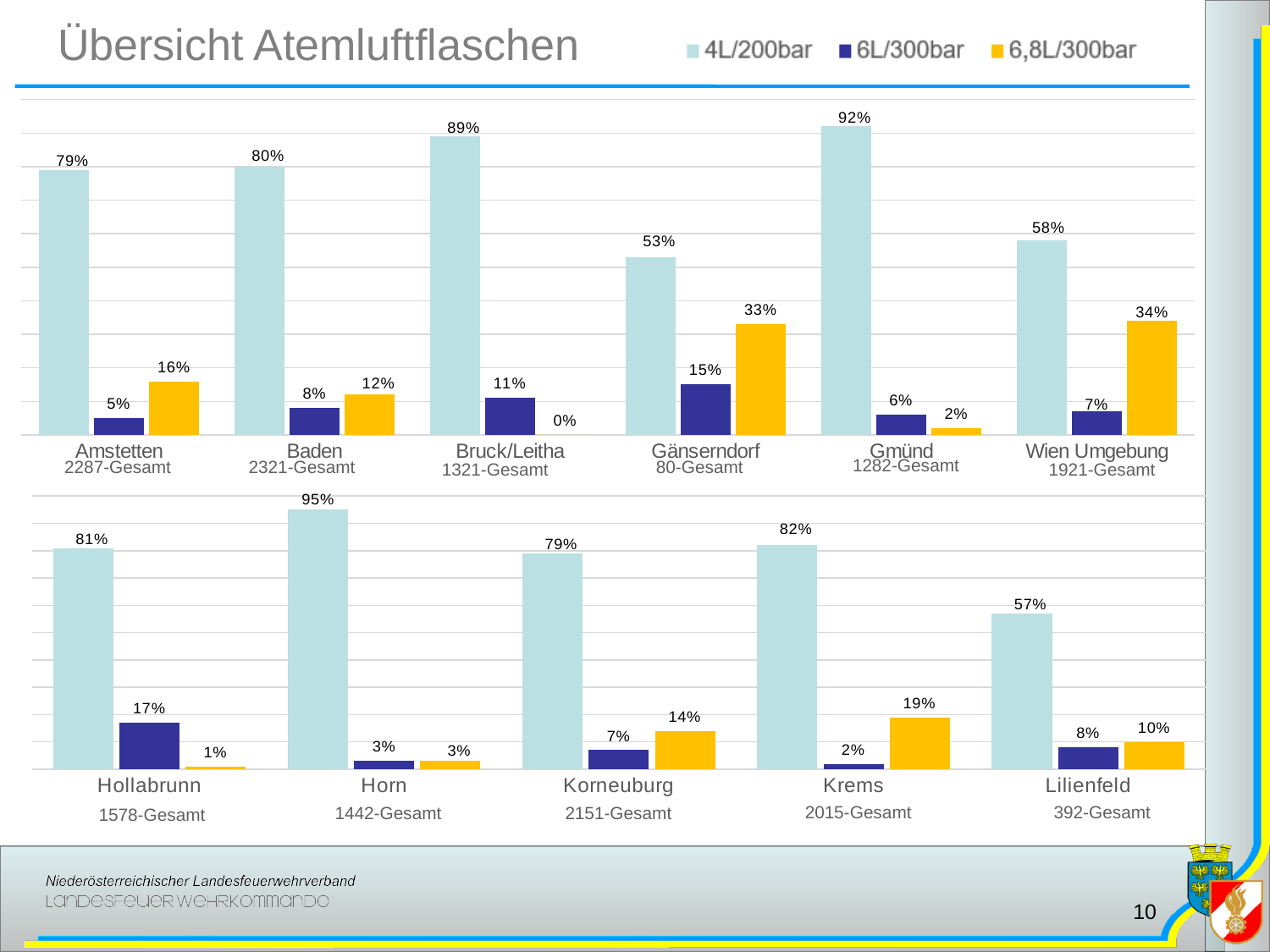
How many series does the legend list? 3 In the top chart, what is the 4L/200bar value for Gmünd? 92% What kind of chart is the top chart? bar chart In the bottom chart, what is the 6,8L/300bar value for Krems? 19% In the top chart, which category has the lowest 4L/200bar value? Gänserndorf What is the title of the slide? Übersicht Atemluftflaschen How many categories are shown in the bottom chart? 5 In the top chart, what is the difference between the 6,8L/300bar values for Wien Umgebung and Baden? 22% In the top chart, what is the 6,8L/300bar value for Bruck/Leitha? 0% In the bottom chart, which is larger: the 6L/300bar value for Hollabrunn or the 6L/300bar value for Lilienfeld? Hollabrunn In the top chart, what is the 6L/300bar value for Gänserndorf? 15% In the bottom chart, which category has the highest 4L/200bar value? Horn